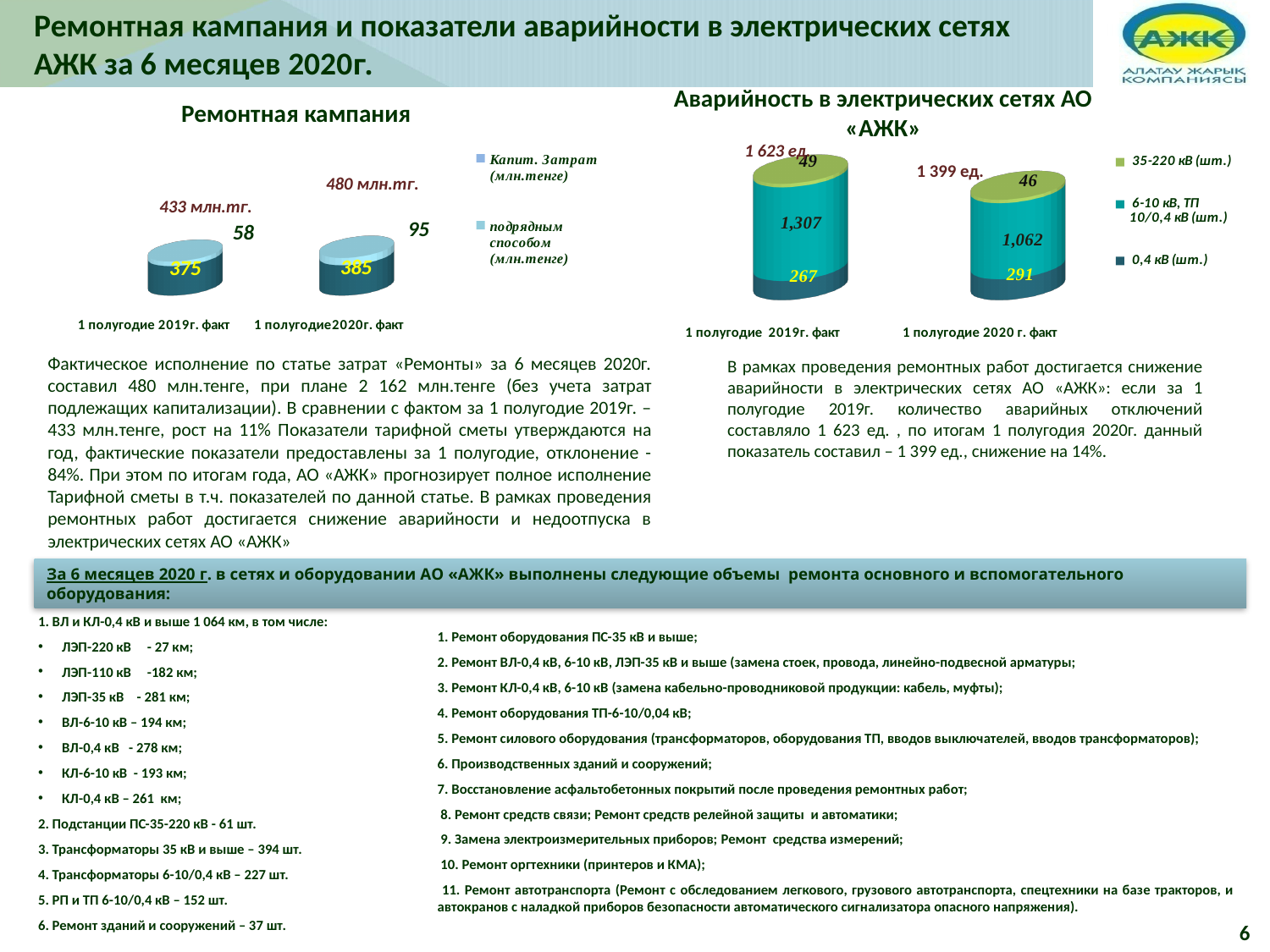
On the «Ремонтная кампания» chart, how many series does the legend list? 2 On the «Аварийность в электрических сетях АО «АЖК»» chart, which period has the larger value for «35-220 кВ (шт.)»: 1 полугодие 2019г. факт or 1 полугодие 2020 г. факт? 1 полугодие 2019г. факт On the «Аварийность в электрических сетях АО «АЖК»» chart, what is the total shown above the bar for 1 полугодие 2019г. факт? 1 623 ед. On the «Ремонтная кампания» chart, what is the total shown above the bar for 1 полугодие 2020г. факт? 480 млн.тг. What type of chart is the «Ремонтная кампания» chart? Stacked bar chart On the «Аварийность в электрических сетях АО «АЖК»» chart, what is the value of «6-10 кВ, ТП 10/0,4 кВ (шт.)» for 1 полугодие 2019г. факт? 1,307 On the «Аварийность в электрических сетях АО «АЖК»» chart, what is the difference between the «6-10 кВ, ТП 10/0,4 кВ (шт.)» values for 1 полугодие 2019г. факт and 1 полугодие 2020 г. факт? 245 On the «Аварийность в электрических сетях АО «АЖК»» chart, how many series does the legend list? 3 On the «Аварийность в электрических сетях АО «АЖК»» chart, what is the value of «0,4 кВ (шт.)» for 1 полугодие 2020 г. факт? 291